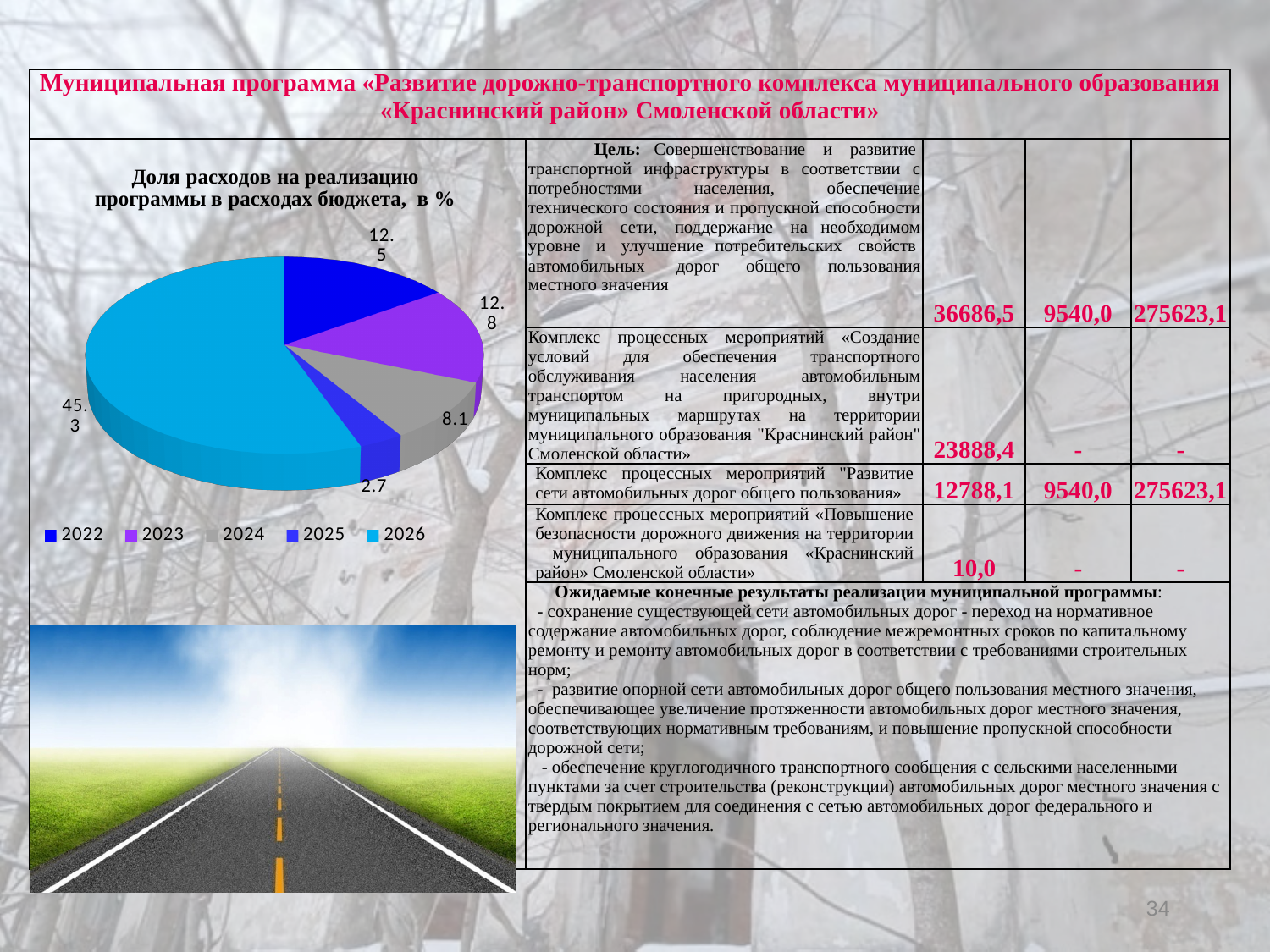
Which year has the smallest share in the pie chart? 2025 Which year has the largest share in the pie chart? 2026 What is the value for 2022 in the pie chart? 12.5 How many series does the legend of the pie chart list? 5 What is the value for 2025 in the pie chart? 2.7 What type of chart is shown on the slide? pie chart How many slices does the pie chart have? 5 What is the value for 2024 in the pie chart? 8.1 Which is larger in the pie chart, the value for 2024 or the value for 2025? 2024 What is the difference between the values for 2026 and 2024 in the pie chart? 37.2 What is the value for 2026 in the pie chart? 45.3 What is the title of the pie chart? Доля расходов на реализацию программы в расходах бюджета, в %